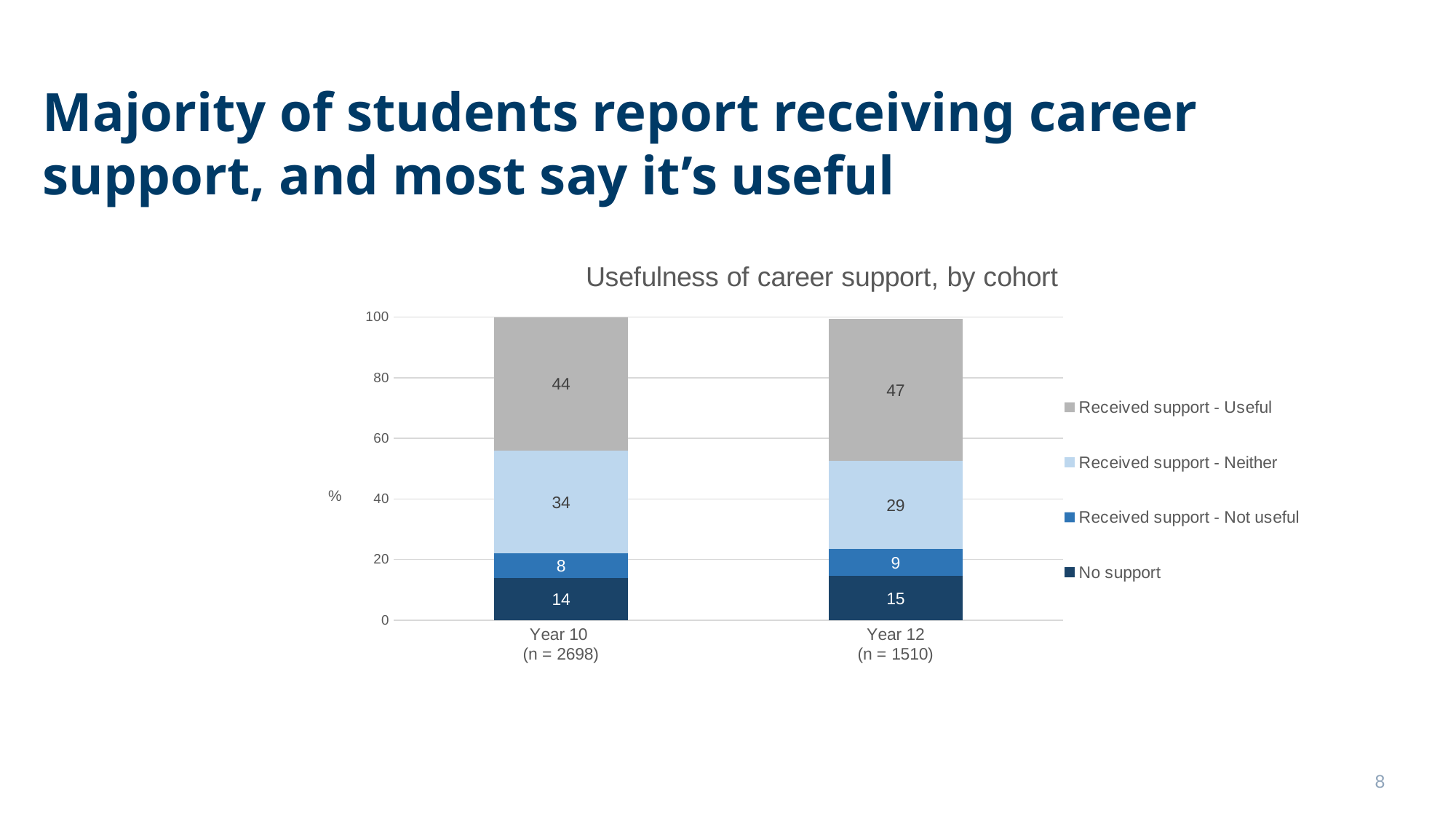
What is the value for 'Received support - Neither' for Year 12? 29 What is the difference between the 'Received support - Neither' values for Year 10 and Year 12? 5 What type of chart is shown on the slide? Stacked bar chart What is the value for 'No support' for Year 12? 15 Which cohort has the higher value for 'Received support - Neither'? Year 10 What is the value for 'Received support - Useful' for Year 10? 44 How many series does the legend list? 4 What is the total of the stacked bar for Year 10? 100 Which cohort has the higher value for 'Received support - Useful'? Year 12 How many cohorts are shown on the x axis? 2 What is the value for 'Received support - Not useful' for Year 10? 8 What is the difference between the 'Received support - Useful' values for Year 12 and Year 10? 3